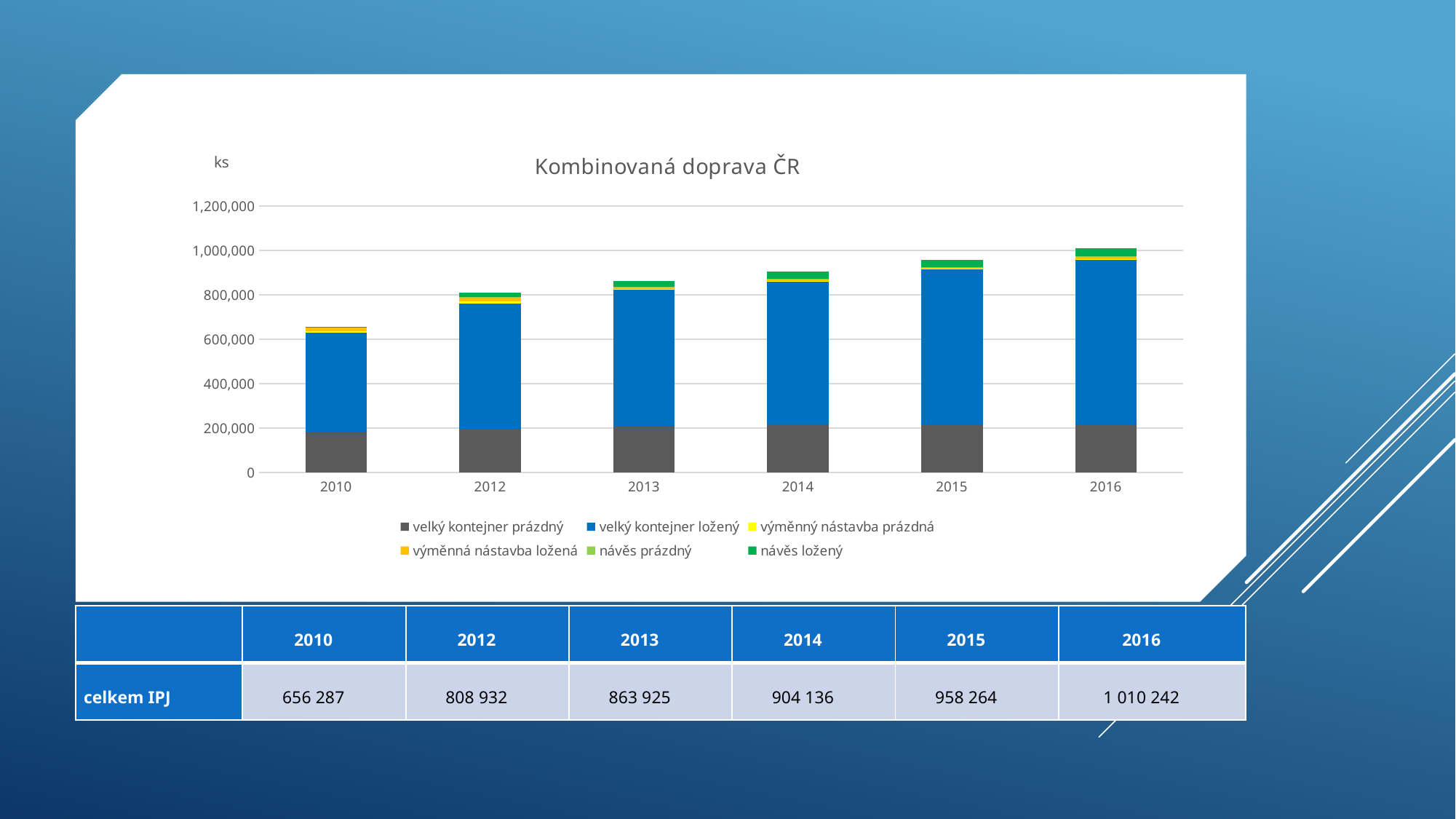
What is the difference between the total for 2016 and the total for 2010? 353 955 How many series does the chart legend list? 6 What is the total (celkem IPJ) for 2013? 863 925 What kind of chart is shown on the slide? Stacked bar chart Which year has the highest total stacked bar? 2016 How many years (categories) are plotted on the x axis of the chart? 6 What is the title of the chart? Kombinovaná doprava ČR Do the total bar heights rise or fall from 2010 to 2016? Rise Which year has the lowest total stacked bar? 2010 Is the total bar for 2013 greater or less than 1,000,000? less Which year has the larger total, 2014 or 2015? 2015 What is the total (celkem IPJ) for 2016? 1 010 242